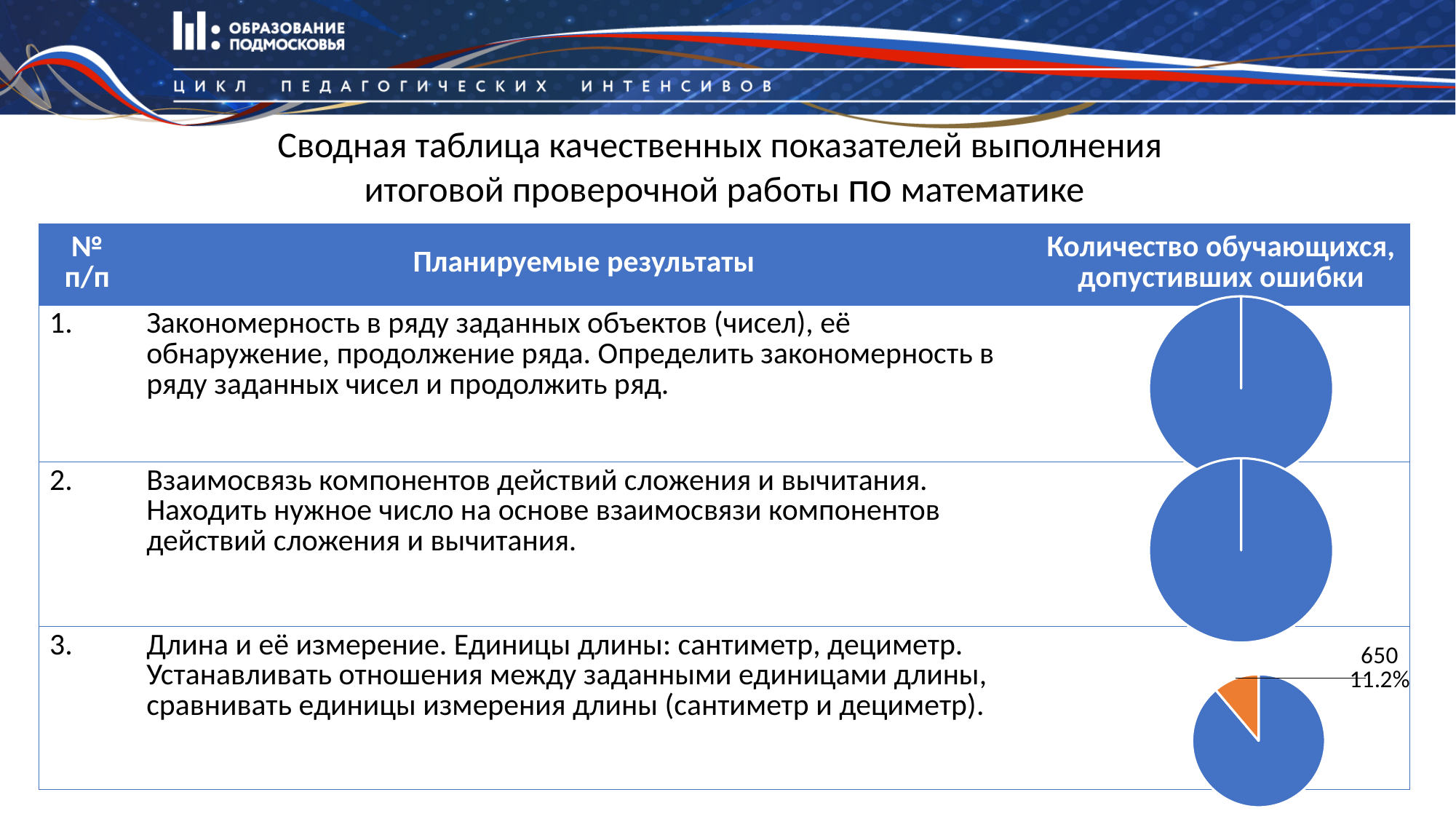
In the pie chart in row 3, is the share of the orange slice greater or less than 50%? less How many visibly distinct slices does the pie chart in row 3 have? 2 What colour fills almost the entire pie chart in row 1? blue In the pie chart in row 3, what value is printed on the data label of the orange slice? 650 In the pie chart in row 3, which slice is larger, the blue one or the orange one? blue Which of the three pie charts on the slide has a visible orange slice? the one in row 3 In the pie chart in row 3, what percentage share is printed for the orange slice? 11.2% What kind of chart is shown in the third row of the table (row 3)? pie chart How many pie charts are shown on the slide? 3